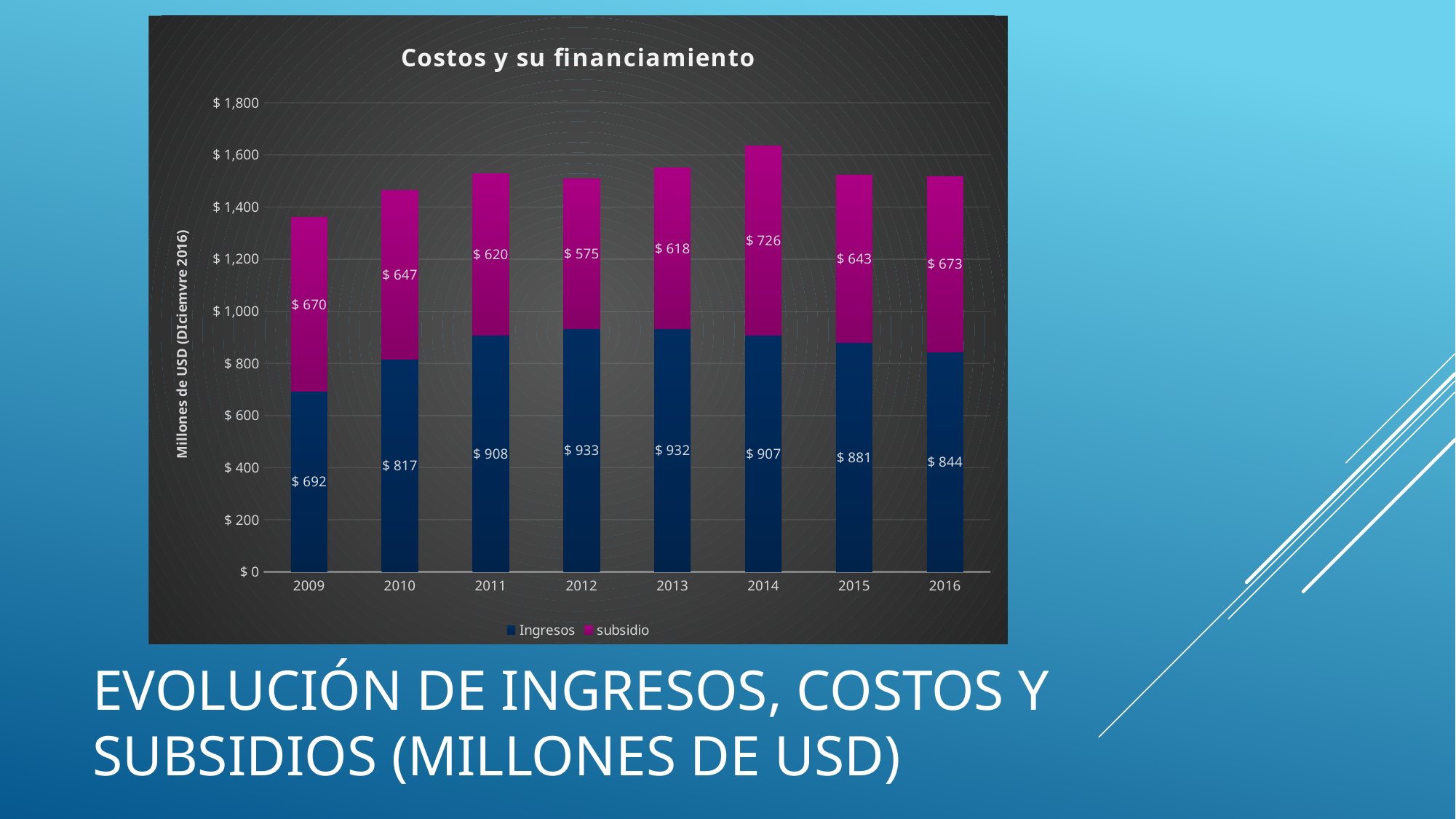
Which year has the lowest subsidio value? 2012 How many years are shown on the x axis? 8 What is the difference between the Ingresos values for 2010 and 2009? $ 125 Which is larger, the subsidio value for 2015 or for 2016? 2016 What is the Ingresos value for 2016? $ 844 How many series does the legend list? 2 What is the subsidio value for 2014? $ 726 What is the total of the stacked bar for 2014? $ 1,633 Which year has the lowest Ingresos value? 2009 What kind of chart is shown on the slide? Stacked bar chart What is the Ingresos value for 2011? $ 908 Which year has the highest subsidio value? 2014